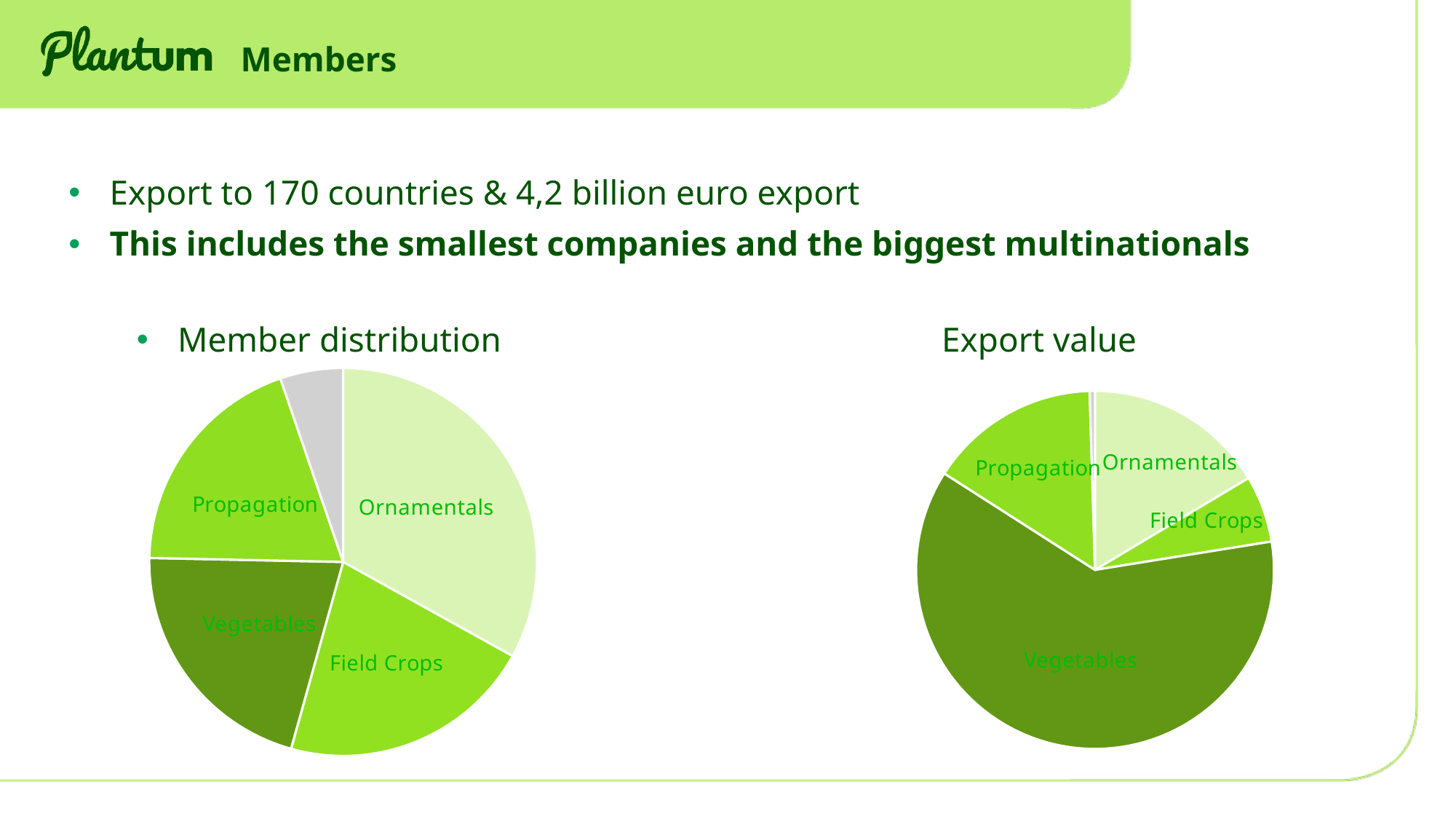
What is the title of the pie chart on the right side of the slide? Export value In the Export value chart, which slice is larger, Ornamentals or Field Crops? Ornamentals In the Export value chart, which slice is larger, Vegetables or Propagation? Vegetables In the Export value chart, which labeled slice is the smallest? Field Crops In the Member distribution chart, which slice is larger, Ornamentals or Field Crops? Ornamentals In the Member distribution chart, which labeled slice is the largest? Ornamentals How many slices does the Export value chart have in total, including the unlabeled one? 5 What kind of chart is the Export value chart? pie chart What kind of chart is the Member distribution chart? pie chart In the Export value chart, which slice is the largest? Vegetables How many labeled slices does the Member distribution chart have? 4